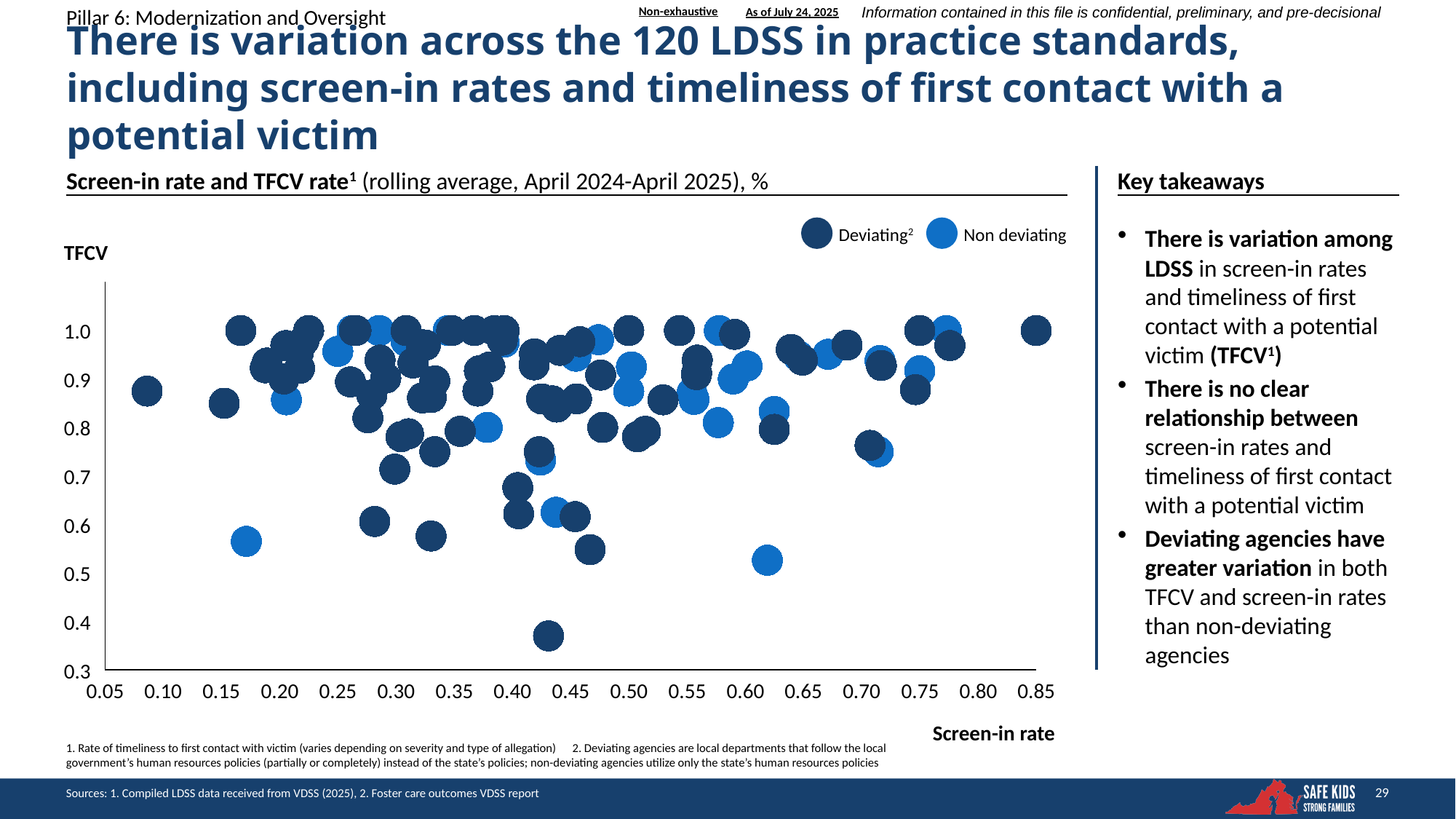
What are the two series named in the chart legend? Deviating and Non deviating Is the lowest TFCV value plotted on the chart greater or less than 0.4? less Does TFCV show a clear rising or falling trend as screen-in rate increases along the x axis? No clear trend Is the TFCV value of the lowest Non deviating point greater or less than 0.6? less What is the label of the horizontal axis of the chart? Screen-in rate What kind of chart is shown on the slide? Scatter plot How many series does the chart legend list? 2 Is the lowest screen-in rate plotted on the chart greater or less than 0.15? less Which series has more points plotted on the chart, Deviating or Non deviating? Deviating Does the point with the lowest TFCV belong to the Deviating or Non deviating series? Deviating